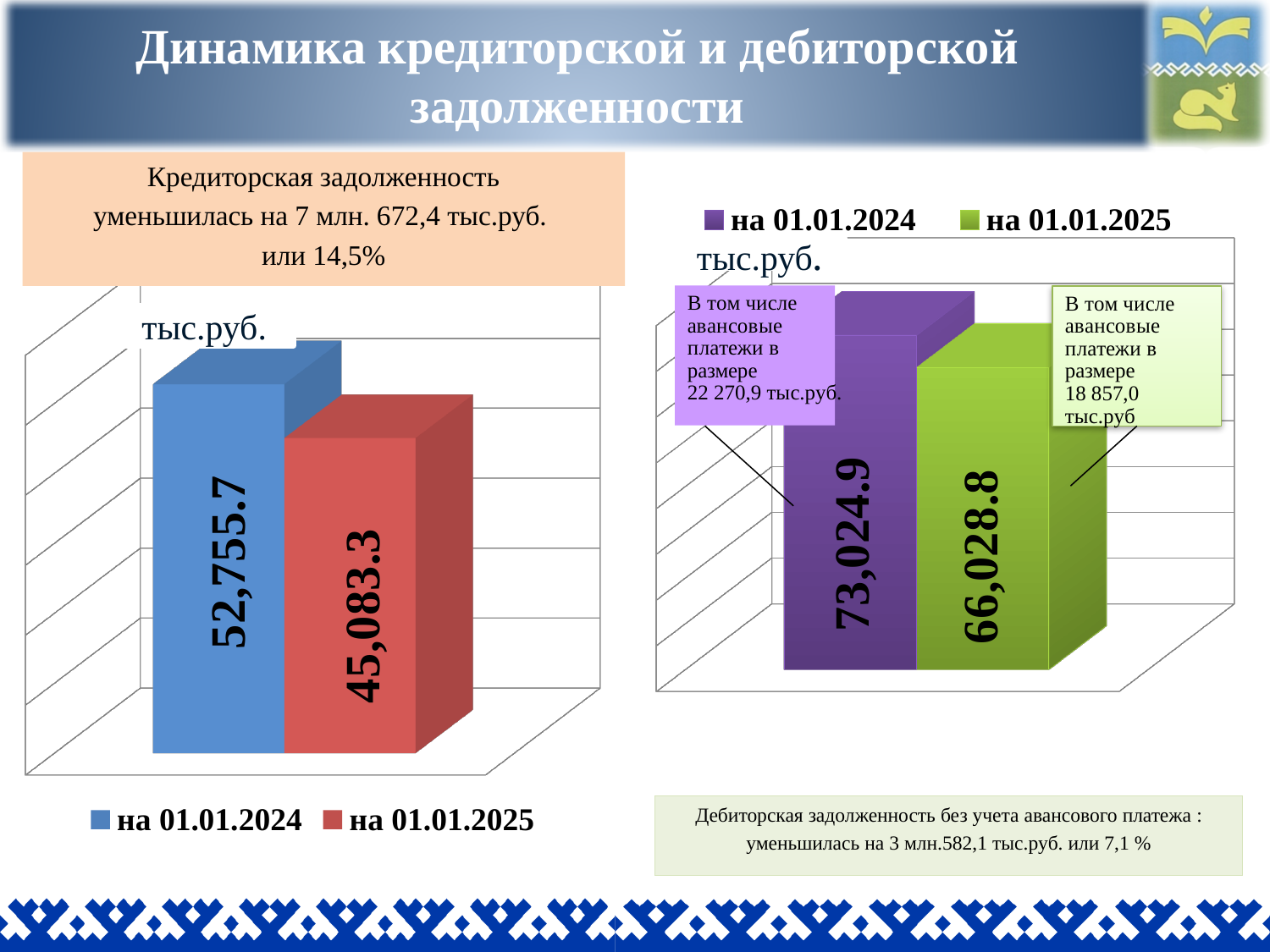
On the right chart, what is the difference between the values for на 01.01.2024 and на 01.01.2025? 6,996.1 On the left chart, what is the value for на 01.01.2025? 45,083.3 How many series does the legend of the left chart list? 2 On the right chart, what is the value for на 01.01.2024? 73,024.9 On the right chart, is the value for на 01.01.2024 larger or smaller than the value for на 01.01.2025? larger On the right chart, which series has the lower value? на 01.01.2025 What type of chart is the right chart? bar chart On the left chart, which series has the higher value? на 01.01.2024 On the left chart, what colour is the bar for на 01.01.2025? red On the left chart, what is the value for на 01.01.2024? 52,755.7 On the left chart, what is the difference between the values for на 01.01.2024 and на 01.01.2025? 7,672.4 On the right chart, what is the value for на 01.01.2025? 66,028.8